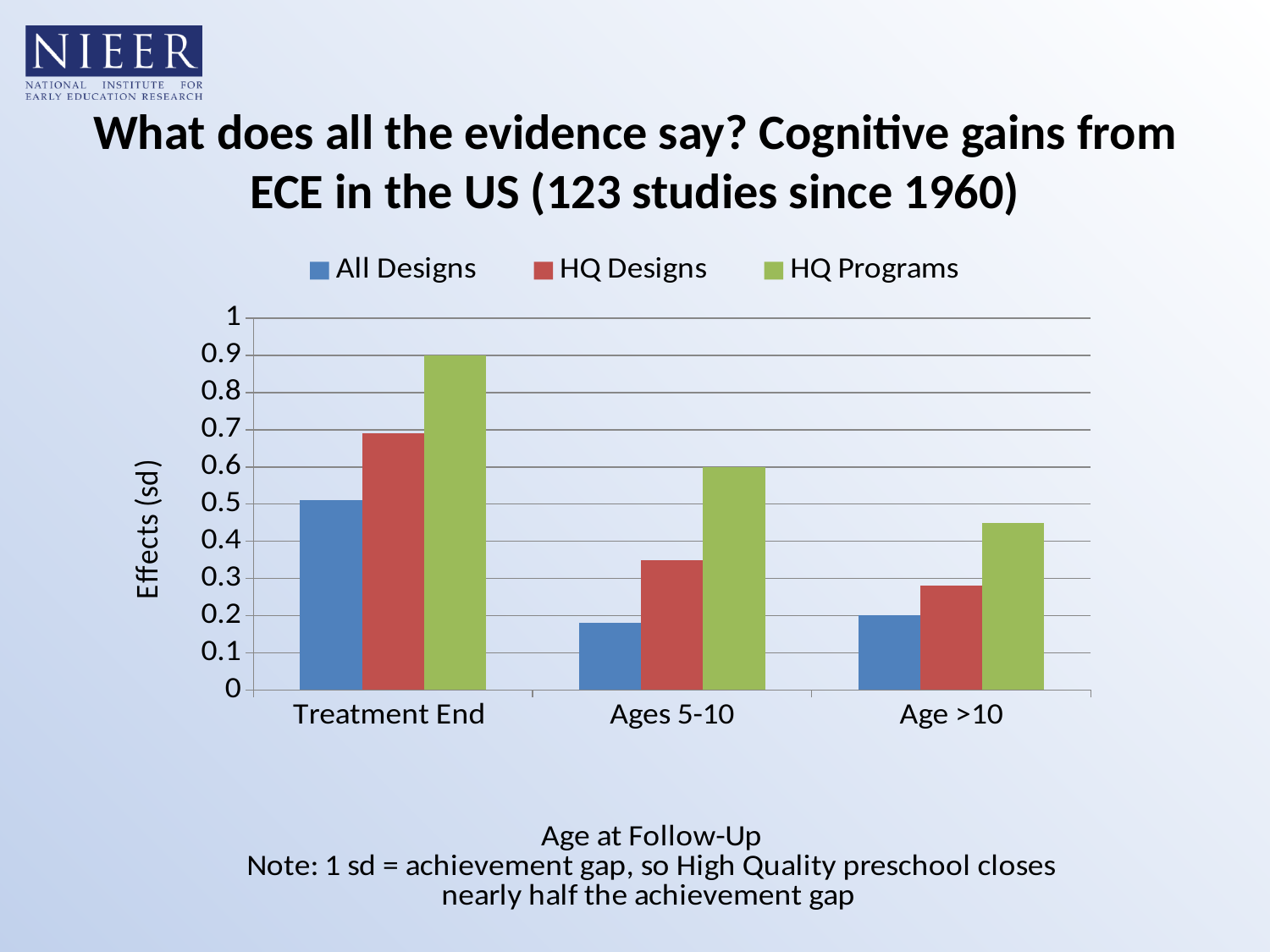
Which series has the lowest value at Ages 5-10? All Designs How many series does the legend list? 3 How many categories are shown on the x axis? 3 Is the value for HQ Programs at Age >10 greater or less than 0.5? less Which is larger for HQ Programs: the value at Ages 5-10 or at Age >10? Ages 5-10 Is the value for HQ Designs at Treatment End greater or less than 0.6? greater Which series has the highest value at Treatment End? HQ Programs What is the label of the y axis? Effects (sd) Is the value for HQ Programs at Treatment End greater or less than 0.8? greater Do the values for All Designs rise or fall from Treatment End to Ages 5-10? fall What kind of chart is shown on the slide? bar chart